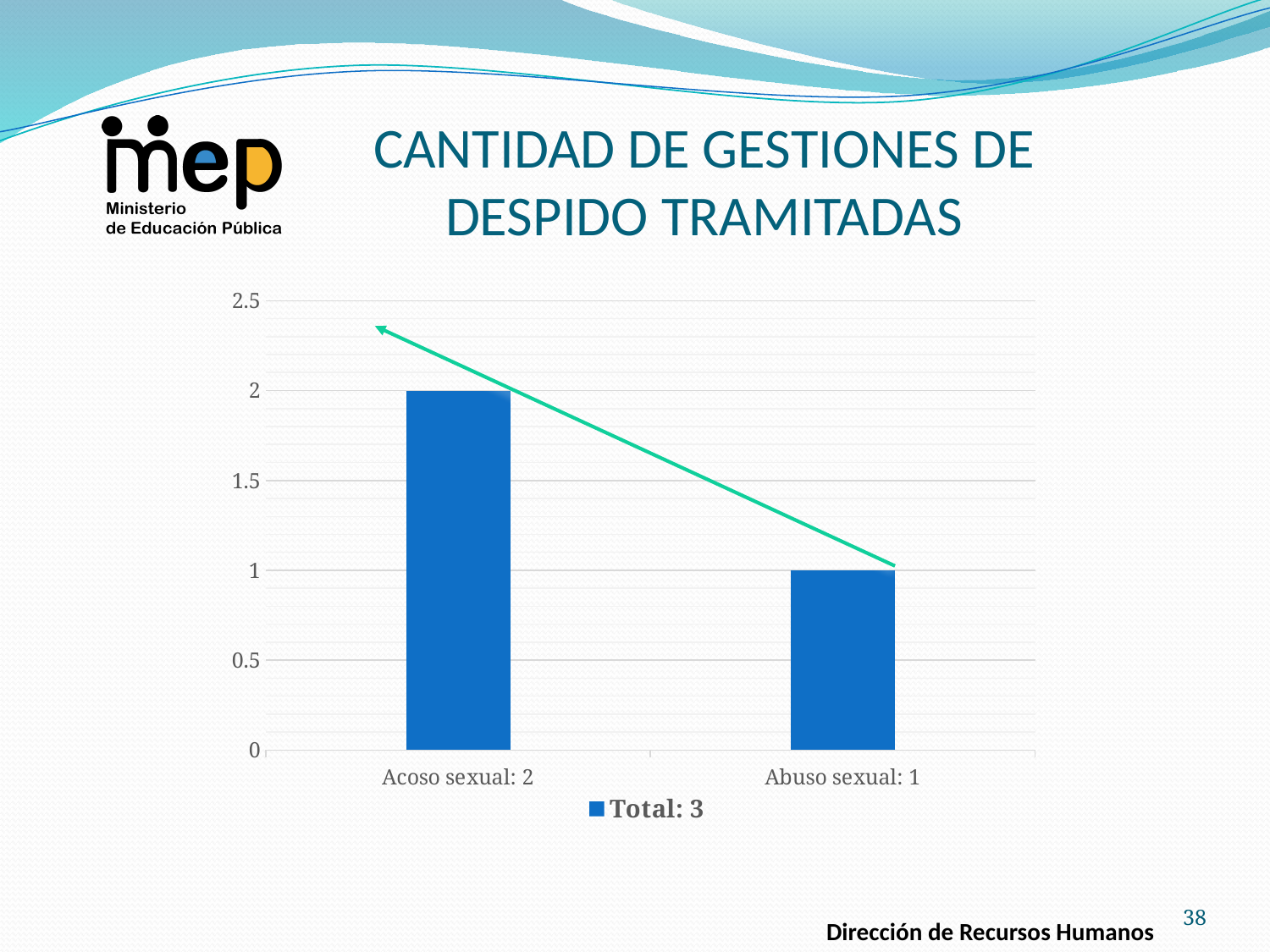
Is the value for Abuso sexual greater or less than 1.5? less Which category has the highest value? Acoso sexual What is the value for Abuso sexual? 1 What kind of chart is shown on the slide? bar chart What is the difference between the values for Acoso sexual and Abuso sexual? 1 How many categories are shown on the x axis? 2 What is the legend entry of the chart? Total: 3 What is the value for Acoso sexual? 2 Is the value for Acoso sexual greater or less than 1.5? greater Which is larger, the value for Acoso sexual or the value for Abuso sexual? Acoso sexual Which category has the lowest value? Abuso sexual Do the values rise or fall from left to right along the x axis? fall